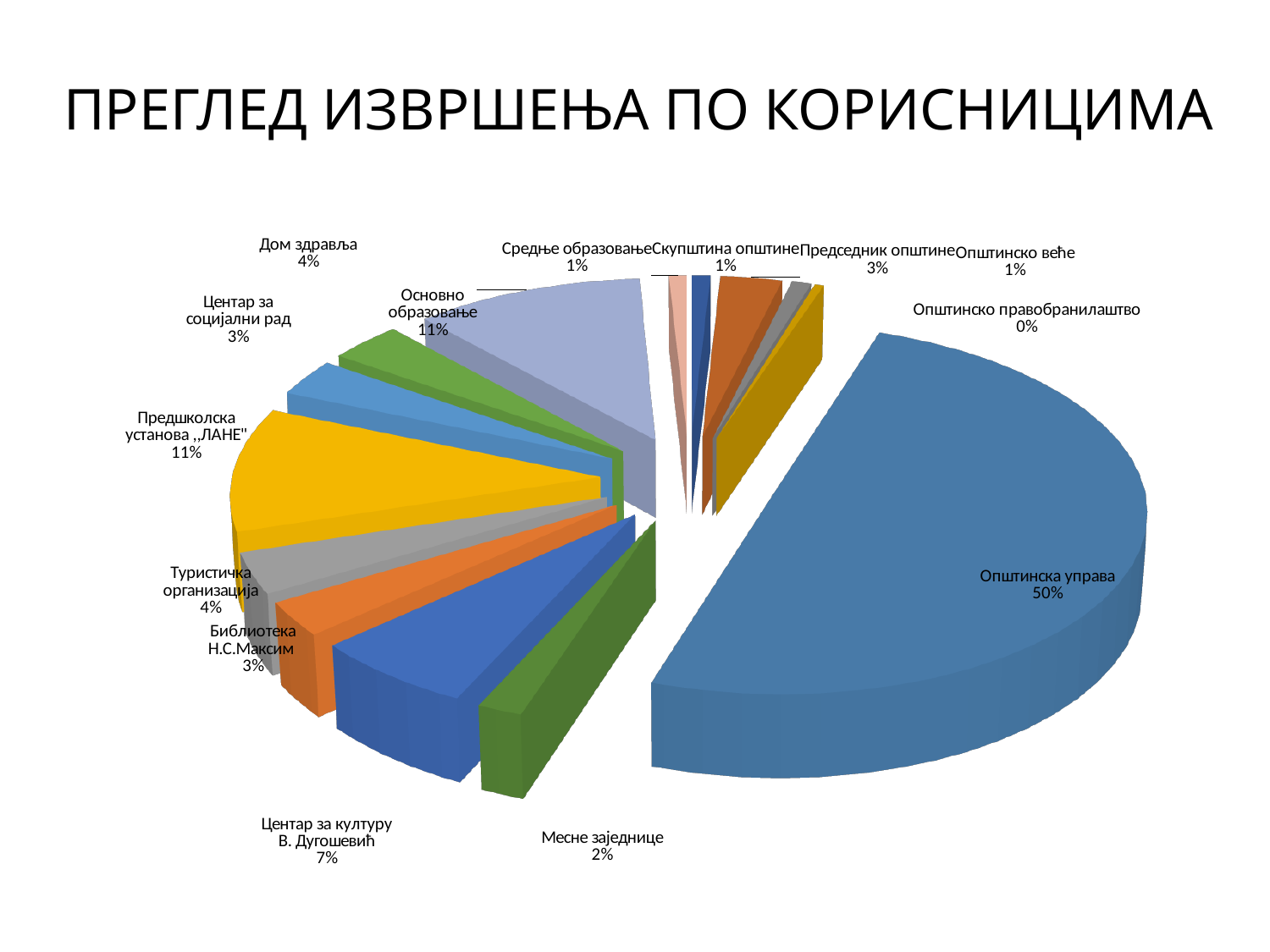
What is the difference between the shares of Општинска управа and Предшколска установа „ЛАНЕ"? 39% Which category has the largest slice of the pie? Општинска управа What is the value shown for Основно образовање? 11% What share of the pie does Општинска управа hold? 50% What kind of chart is shown on the slide? Pie chart How many categories are shown in the pie chart? 14 Which category has the smallest share, labelled 0%? Општинско правобранилаштво What is the value shown for Председник општине? 3% Which is larger, the share for Дом здравља or the share for Месне заједнице? Дом здравља What is the title of the slide? ПРЕГЛЕД ИЗВРШЕЊА ПО КОРИСНИЦИМА What is the value shown for Центар за културу В. Дугошевић? 7% What is the value shown for Месне заједнице? 2%